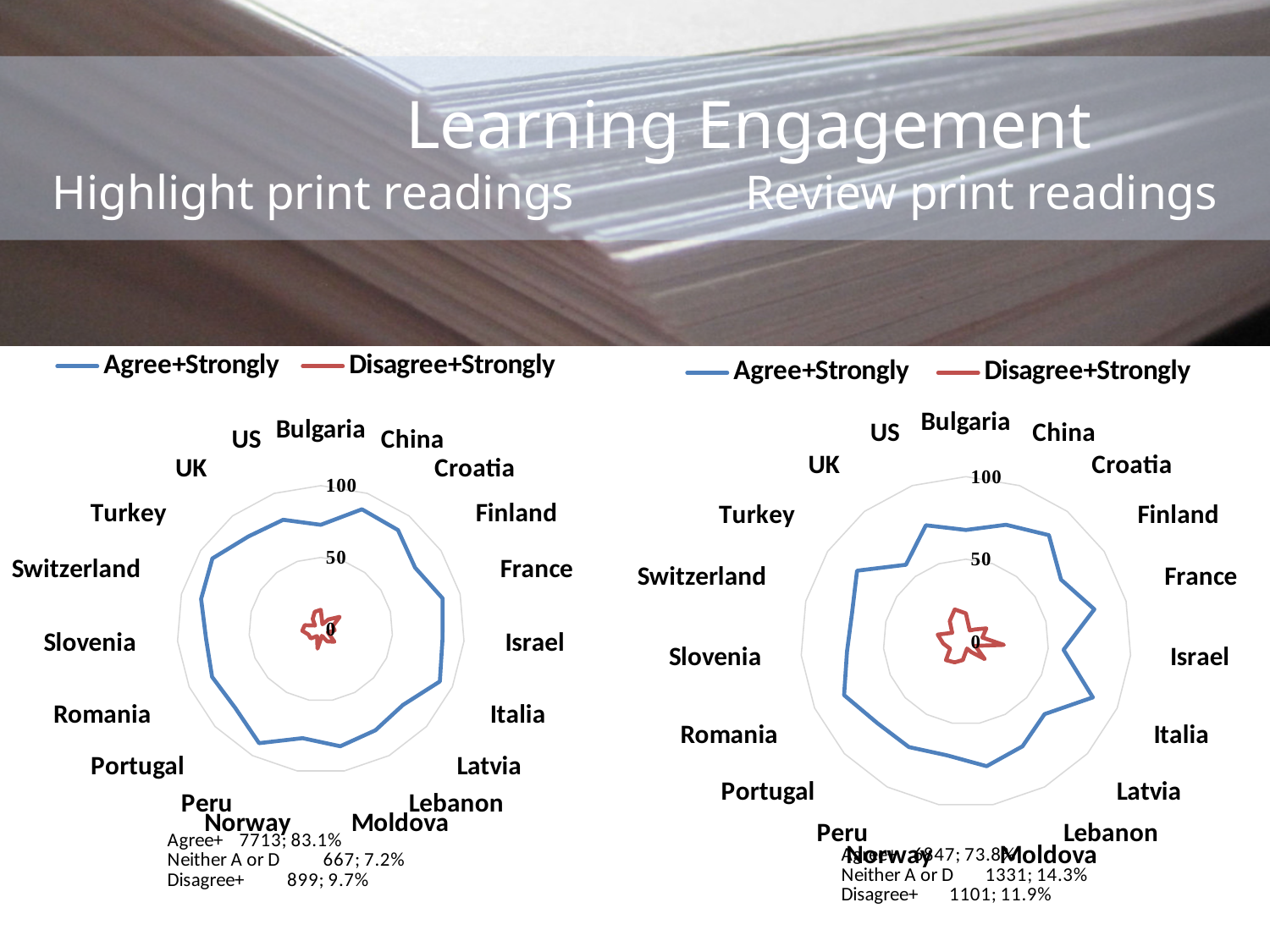
What kind of chart is the 'Highlight print readings' chart on the left? Radar chart In the 'Highlight print readings' chart on the left, which series has the larger value for Italia, Agree+Strongly or Disagree+Strongly? Agree+Strongly In the 'Review print readings' chart on the right, which series has the larger value for Switzerland, Agree+Strongly or Disagree+Strongly? Agree+Strongly In the 'Review print readings' chart on the right, is the Disagree+Strongly value for Romania greater or less than 50? less In the 'Highlight print readings' chart on the left, is the Disagree+Strongly value for Slovenia greater or less than 50? less In the 'Highlight print readings' chart on the left, is the Agree+Strongly value for France greater or less than 50? greater What are the two legend entries of the 'Highlight print readings' chart on the left? Agree+Strongly and Disagree+Strongly How many countries are plotted around the 'Highlight print readings' chart on the left? 19 What is the highest axis tick value shown on the 'Highlight print readings' chart on the left? 100 What colour is the Disagree+Strongly series in the 'Review print readings' chart on the right? Red How many series does the legend of the 'Review print readings' chart on the right list? 2